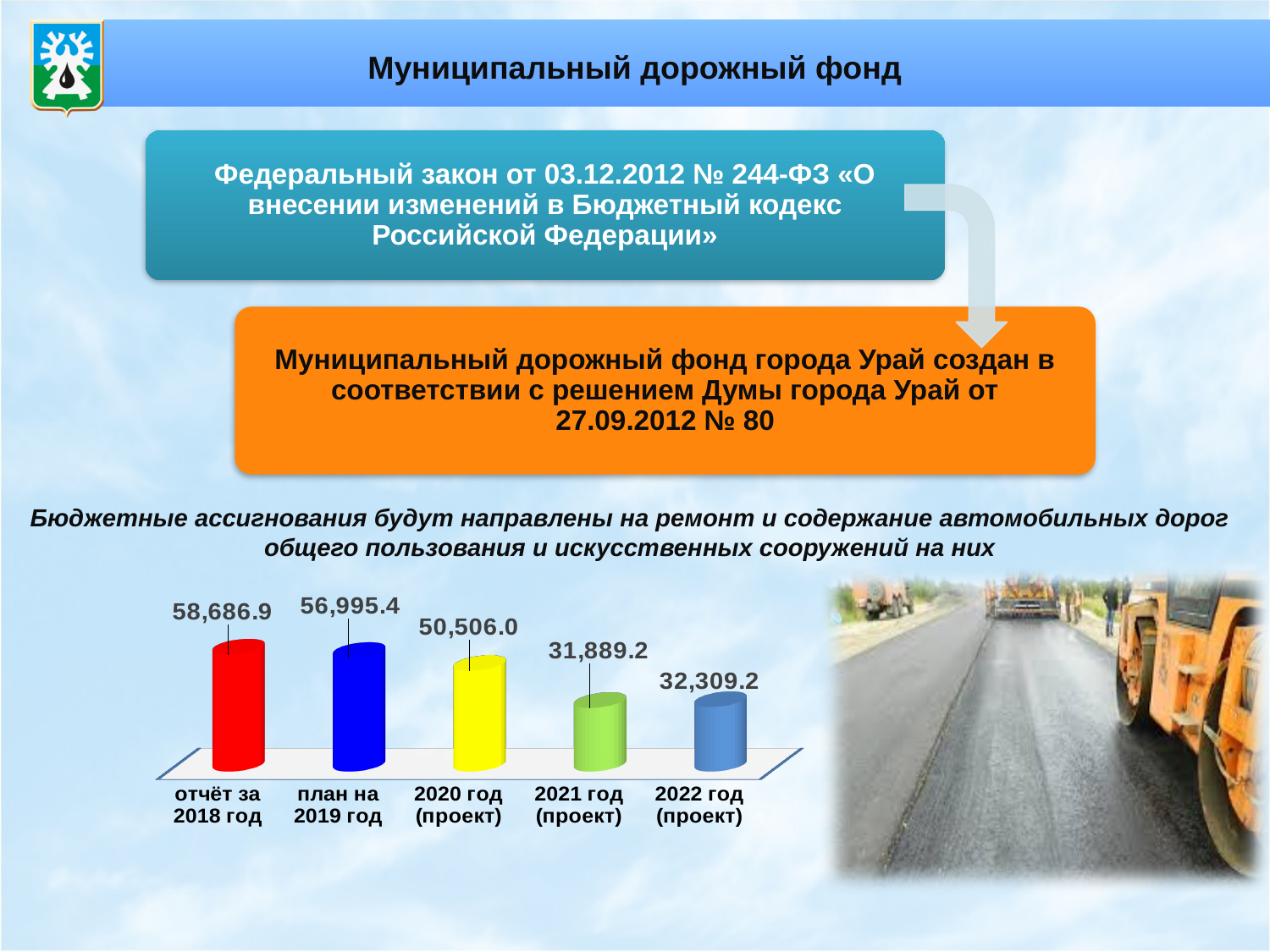
Which category has the highest value? отчёт за 2018 год What is the difference between the values for «2022 год (проект)» and «2021 год (проект)»? 420.0 What is the value shown for «2021 год (проект)»? 31,889.2 What is the value shown for «2020 год (проект)»? 50,506.0 What is the value shown for «план на 2019 год»? 56,995.4 Which is larger, the value for «2021 год (проект)» or «2022 год (проект)»? 2022 год (проект) What kind of chart is shown on the slide? bar chart How many categories are shown in the chart? 5 What is the value shown for «отчёт за 2018 год»? 58,686.9 What is the difference between the values for «отчёт за 2018 год» and «план на 2019 год»? 1,691.5 Which category has the lowest value? 2021 год (проект) What is the value shown for «2022 год (проект)»? 32,309.2